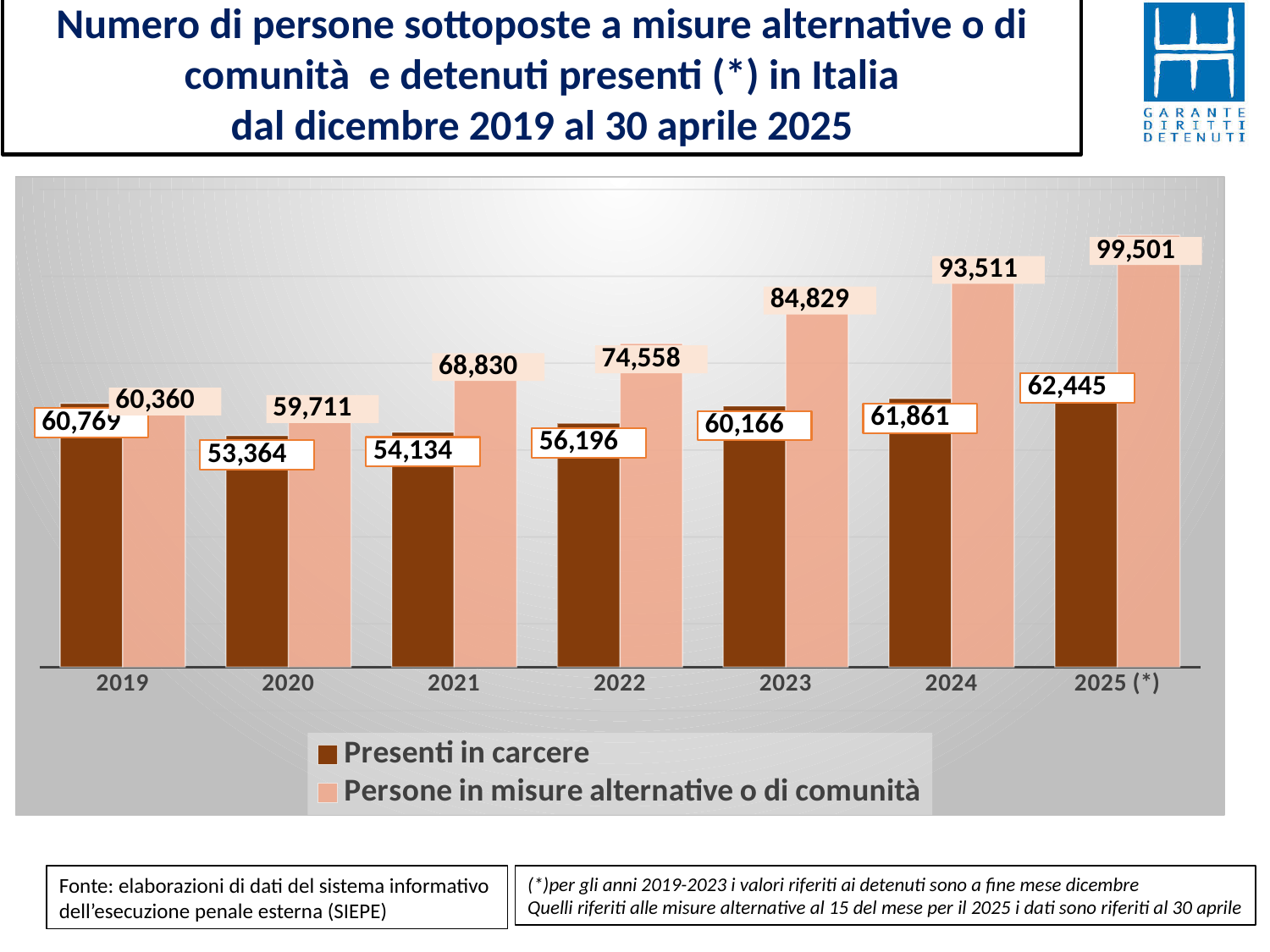
What is the difference between Persone in misure alternative o di comunità and Presenti in carcere in 2024? 31,650 By how much did Persone in misure alternative o di comunità increase from 2024 to 2025 (*)? 5,990 Do the values for Persone in misure alternative o di comunità rise or fall from 2021 to 2025 (*)? Rise In which year is the value for Presenti in carcere the lowest? 2020 What is the value for Presenti in carcere in 2020? 53,364 What kind of chart is shown on the slide? Bar chart In which year is the value for Persone in misure alternative o di comunità the highest? 2025 (*) What is the value for Presenti in carcere in 2023? 60,166 How many series does the legend list? 2 How many years are shown on the x axis? 7 What is the value for Persone in misure alternative o di comunità in 2025 (*)? 99,501 In 2022, which series has the larger value, Presenti in carcere or Persone in misure alternative o di comunità? Persone in misure alternative o di comunità